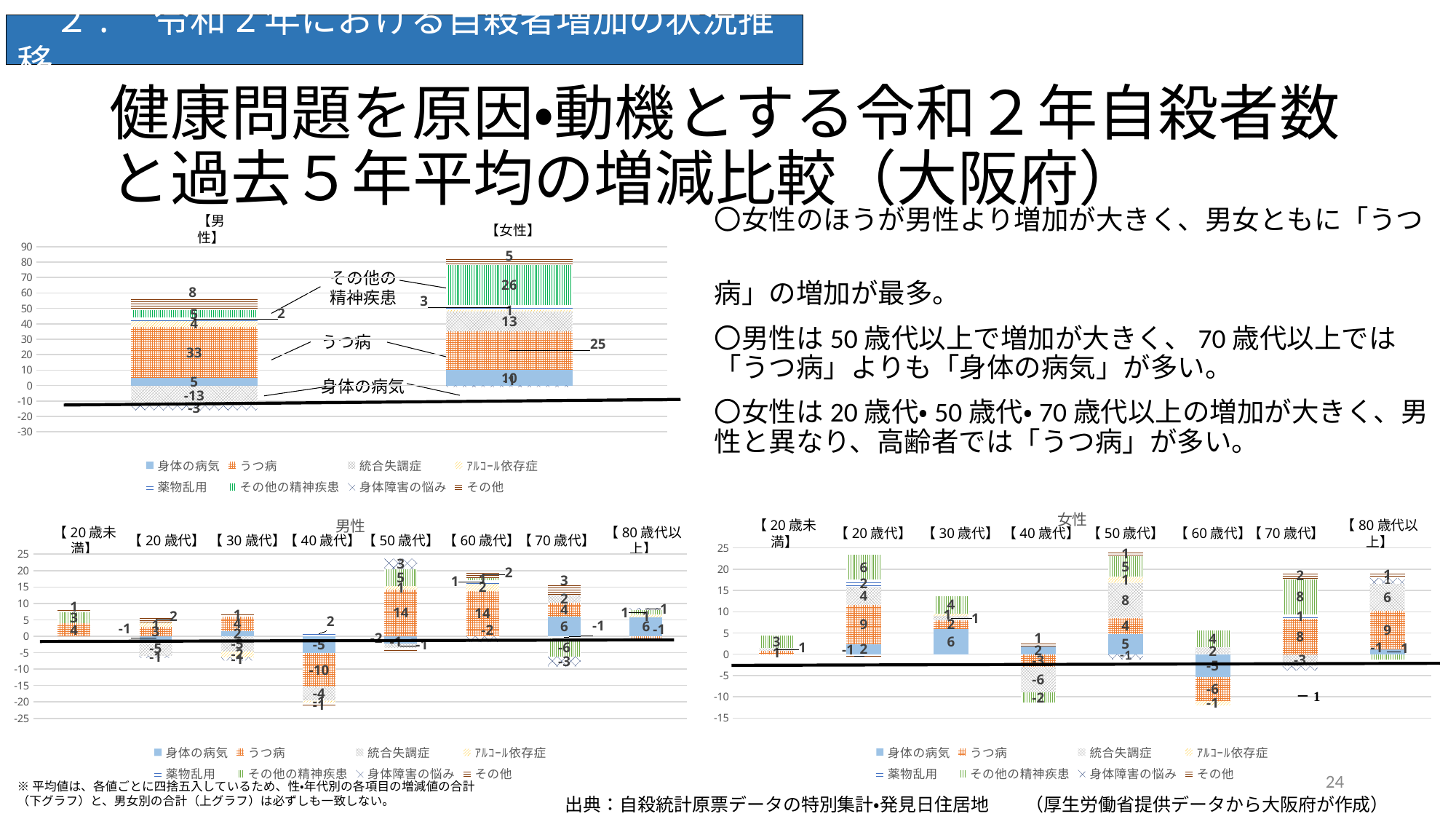
In the bottom-left 男性 chart, what is the value of うつ病 for 【40歳代】? -10 In the bottom-right 女性 chart, what is the value of うつ病 for 【20歳代】? 9 In the top-left chart (【男性】/【女性】), what is the value of その他の精神疾患 for 女性? 26 In the top-left chart (【男性】/【女性】), which has the larger うつ病 value, 男性 or 女性? 男性 In the bottom-right 女性 chart, what is the value of 身体の病気 for 【60歳代】? -5 What kind of chart is the top-left chart (【男性】/【女性】)? Stacked bar chart In the top-left chart (【男性】/【女性】), what is the value of うつ病 for 男性? 33 How many age-group categories are shown in the bottom-left 男性 chart? 8 In the top-left chart (【男性】/【女性】), what is the value of 統合失調症 for 男性? -13 How many series does the legend of the bottom-left 男性 chart list? 8 In the top-left chart (【男性】/【女性】), what is the difference between the うつ病 values for 男性 and 女性? 8 In the top-left chart (【男性】/【女性】), what is the value of うつ病 for 女性? 25